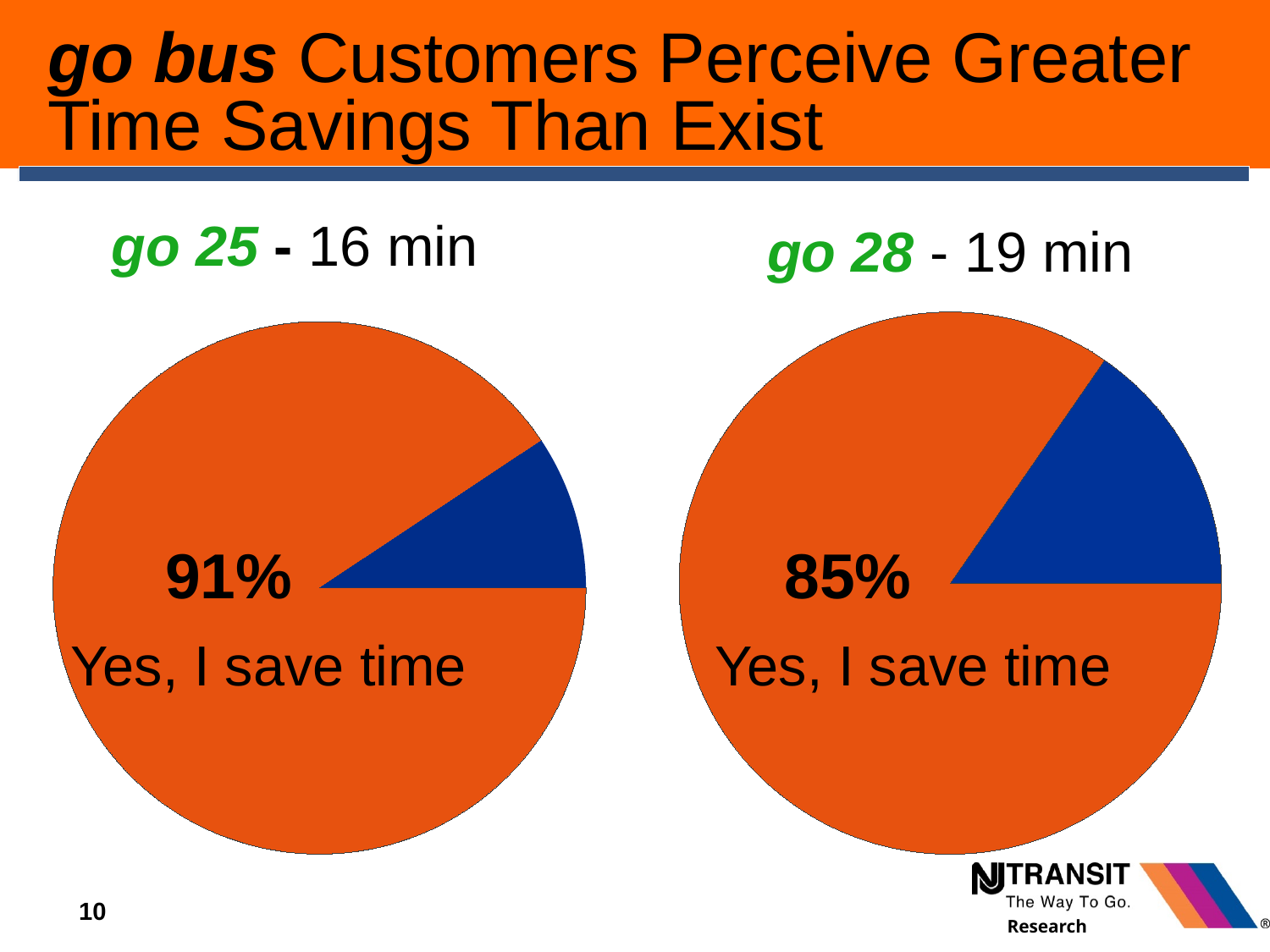
How many pie charts are shown on the slide? 2 In the "go 25 - 16 min" pie chart, what share of customers say "Yes, I save time"? 91% What is the heading above the left pie chart? go 25 - 16 min In the "go 28 - 19 min" pie chart, what share of customers say "Yes, I save time"? 85% In the "go 28 - 19 min" pie chart, is the "Yes, I save time" share greater or less than 50%? greater What kind of chart is shown under the heading "go 25 - 16 min"? Pie chart What is the difference in percentage points between the "Yes, I save time" share in the "go 25 - 16 min" chart and the "go 28 - 19 min" chart? 6 percentage points What colour is the "Yes, I save time" slice in the "go 28 - 19 min" pie chart? Orange Which pie chart shows the larger "Yes, I save time" share, "go 25 - 16 min" or "go 28 - 19 min"? go 25 - 16 min In the "go 25 - 16 min" pie chart, is the orange slice larger or smaller than the blue slice? larger How many slices does the "go 28 - 19 min" pie chart have? 2